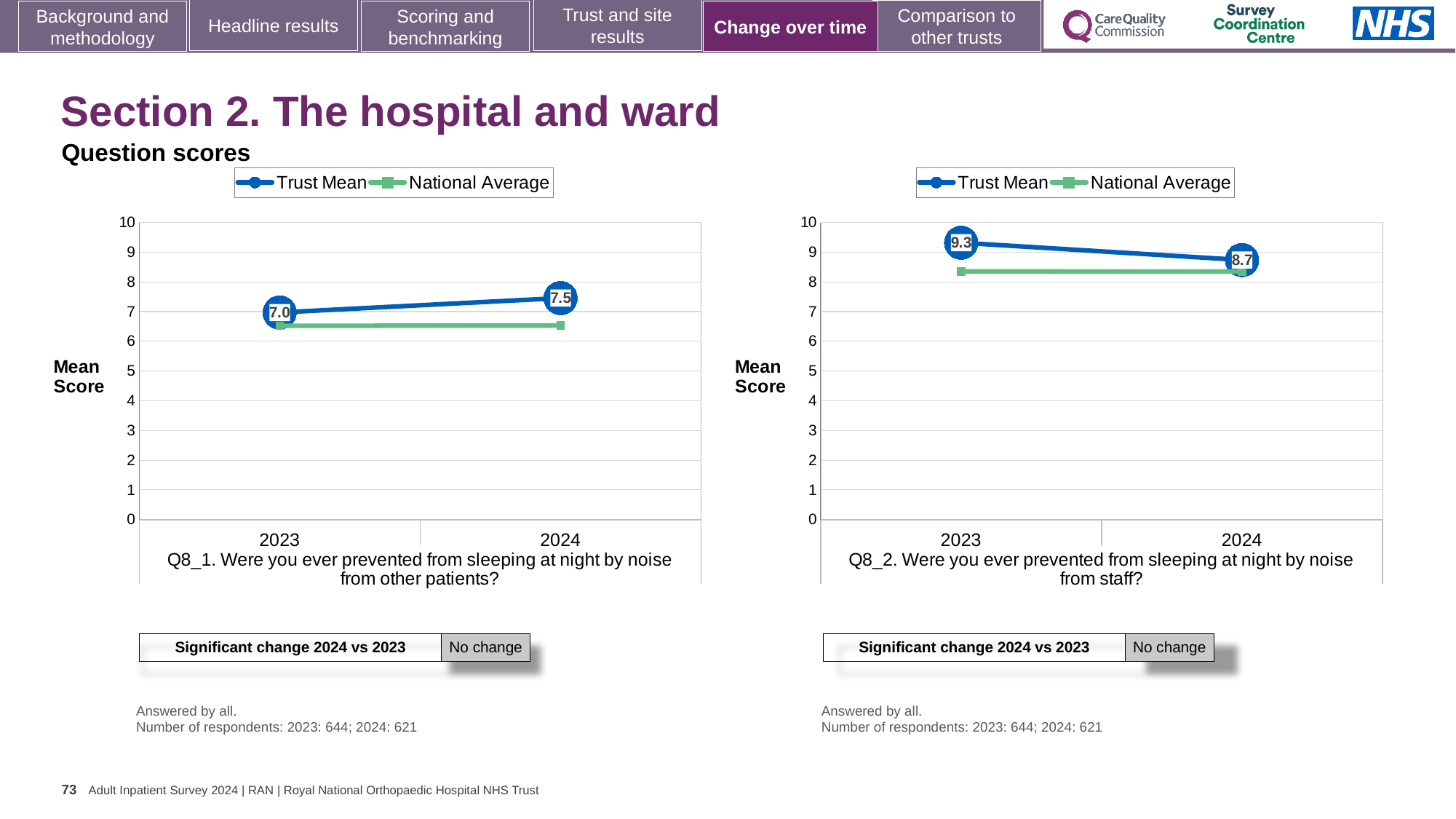
In the left chart (Q8_1), is the National Average for 2024 greater or less than 7? less In the right chart (Q8_2, noise from staff), what is the Trust Mean for 2023? 9.3 In the right chart (Q8_2, noise from staff), what is the Trust Mean for 2024? 8.7 In the right chart (Q8_2), does the Trust Mean rise or fall from 2023 to 2024? fall What type of chart is used for Q8_2 on the right? line chart In the left chart (Q8_1), by how much did the Trust Mean change from 2023 to 2024? 0.5 How many series does the legend of the left chart list? 2 In the right chart (Q8_2), is the National Average for 2023 greater or less than 8? greater In the left chart (Q8_1, noise from other patients), what is the Trust Mean for 2023? 7.0 In the right chart (Q8_2), what is the difference between the Trust Mean in 2023 and 2024? 0.6 In the left chart (Q8_1, noise from other patients), what is the Trust Mean for 2024? 7.5 In the left chart (Q8_1), does the Trust Mean rise or fall from 2023 to 2024? rise